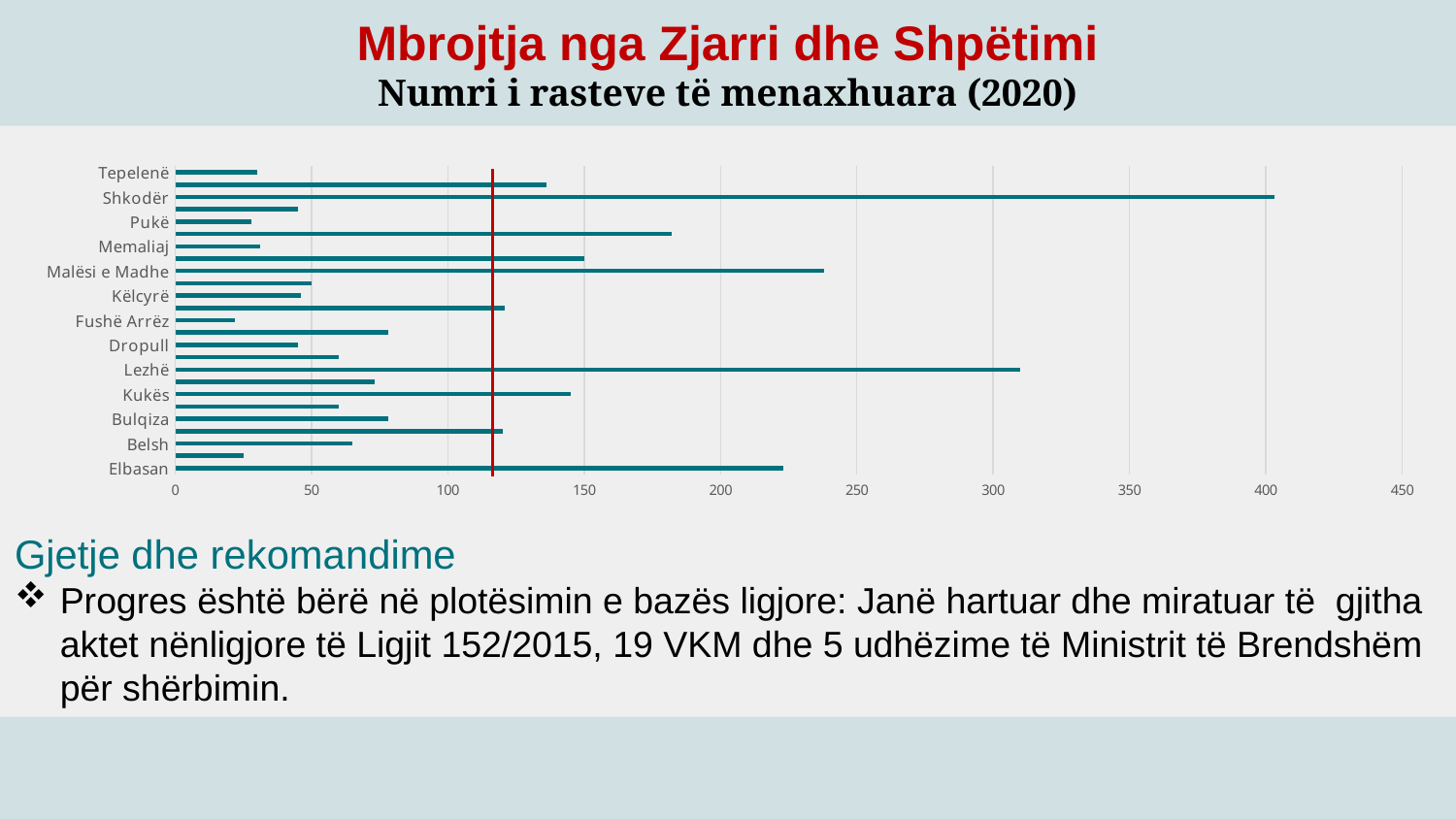
What is the highest value shown on the x axis of the chart? 450 Is the value for Lezhë greater or less than 250? greater Is the value for Tepelenë greater or less than 50? less Which labeled category has the longest bar in the chart? Shkodër Which is larger, the value for Shkodër or the value for Lezhë? Shkodër Is the value for Elbasan greater or less than 50? greater What kind of chart is shown on the slide? bar chart What colour is the vertical reference line drawn across the chart? red Which is larger, the value for Lezhë or the value for Malësi e Madhe? Lezhë